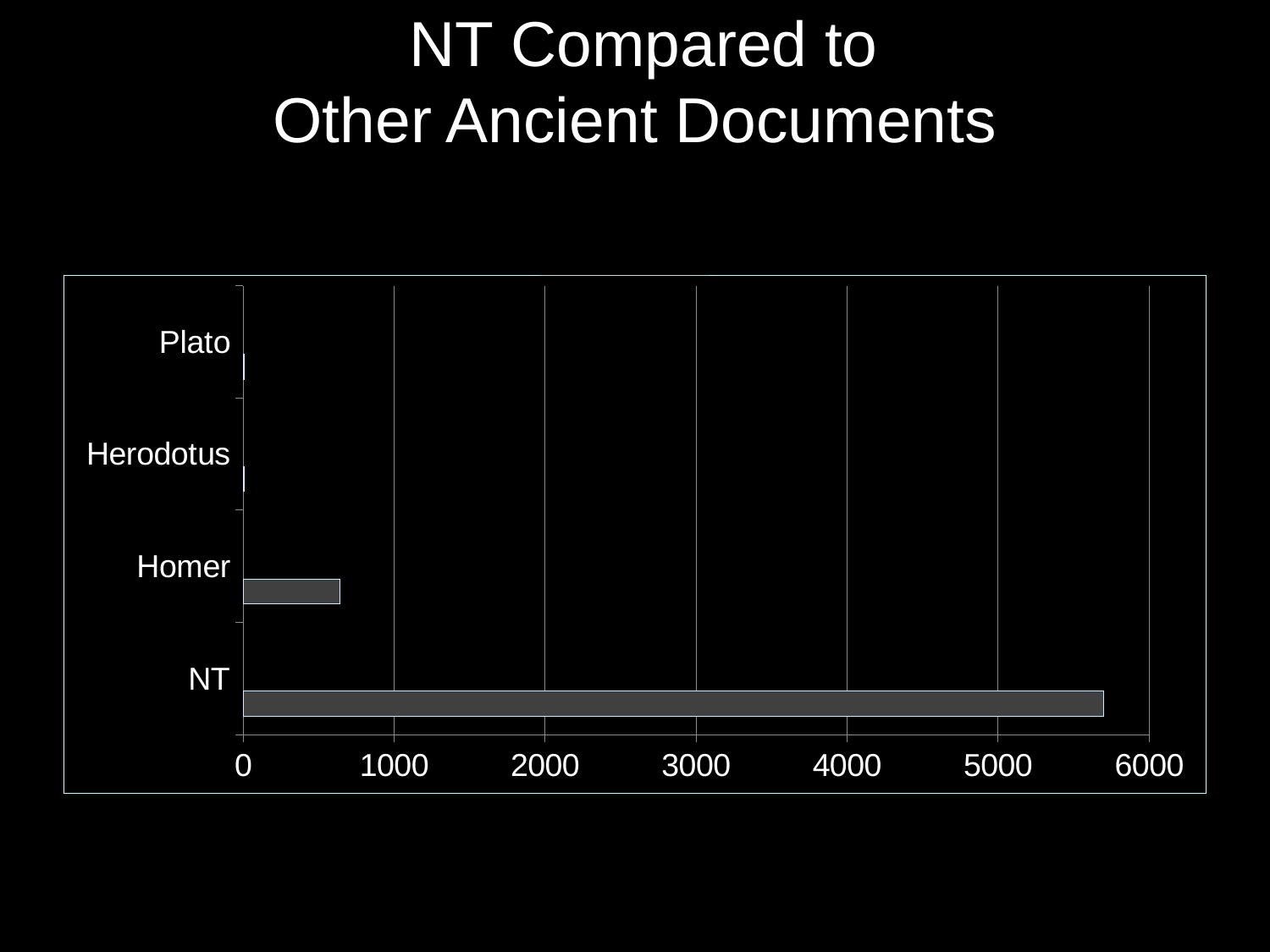
Is the value for Herodotus greater or less than 1000? less Which is larger, the value for Homer or the value for Plato? Homer Is the value for NT greater or less than 6000? less Is the value for Homer greater or less than 1000? less Which is larger, the value for NT or the value for Homer? NT What kind of chart is shown on the slide? bar chart How many categories are shown on the chart? 4 What is the highest value shown on the x axis? 6000 What is the title of the chart on the slide? NT Compared to Other Ancient Documents Which category has the highest value? NT